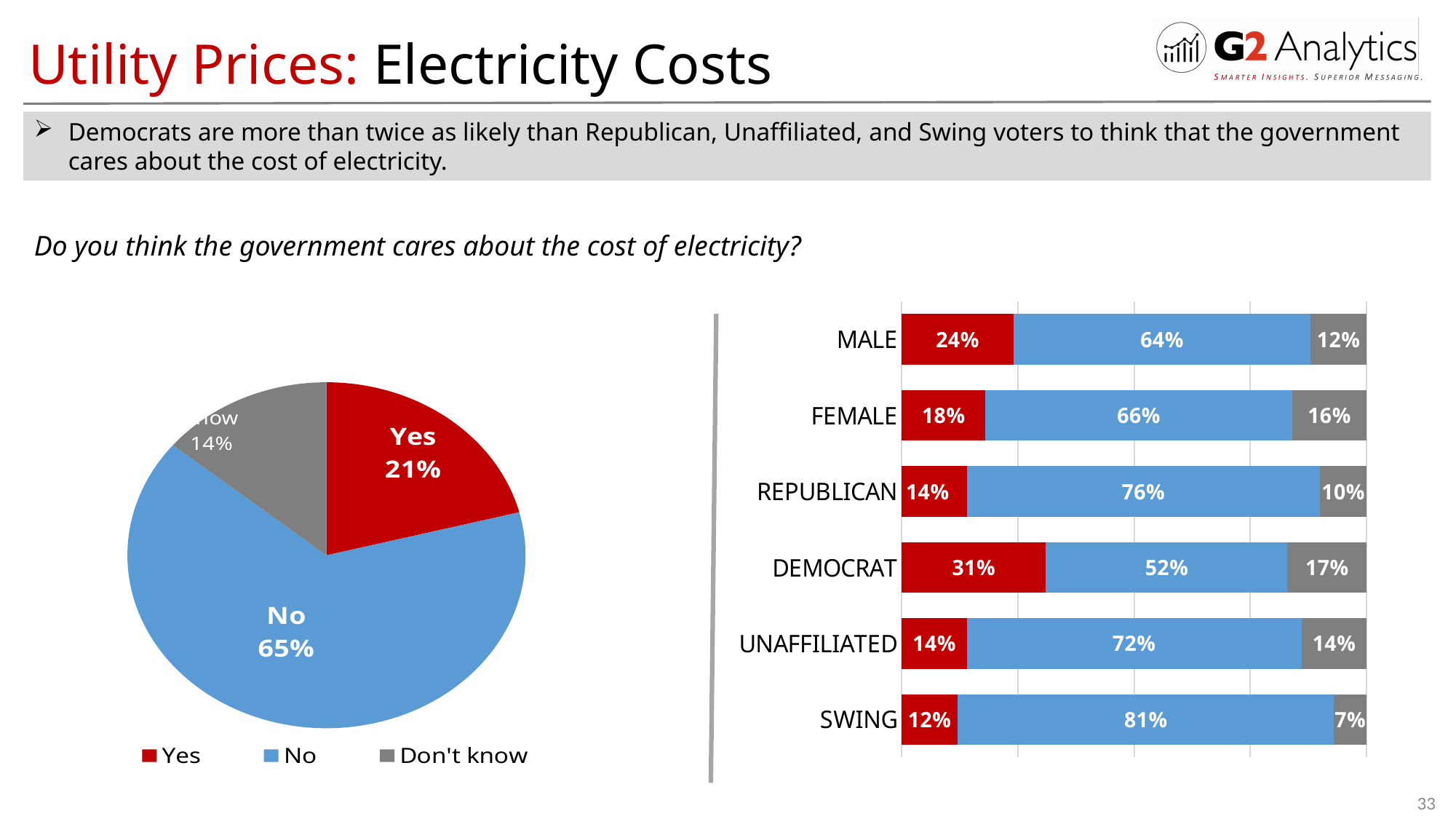
In the pie chart on the left, how many entries does the legend list? 3 In the bar chart on the right, which group has the lowest "No" (blue) value? DEMOCRAT In the bar chart on the right, how many groups are shown? 6 In the bar chart on the right, what is the "No" (blue) value for SWING? 81% In the bar chart on the right, what is the "Yes" (red) value for DEMOCRAT? 31% What kind of chart is on the right side of the slide? Stacked bar chart In the pie chart on the left, what share of respondents answered "No"? 65% In the bar chart on the right, what is the difference between the "Yes" values for MALE and FEMALE? 6% In the pie chart on the left, which response has the largest slice? No In the bar chart on the right, which group has the highest "Yes" (red) value? DEMOCRAT In the bar chart on the right, what is the "Don't know" (grey) value for FEMALE? 16% In the pie chart on the left, what share of respondents answered "Yes"? 21%